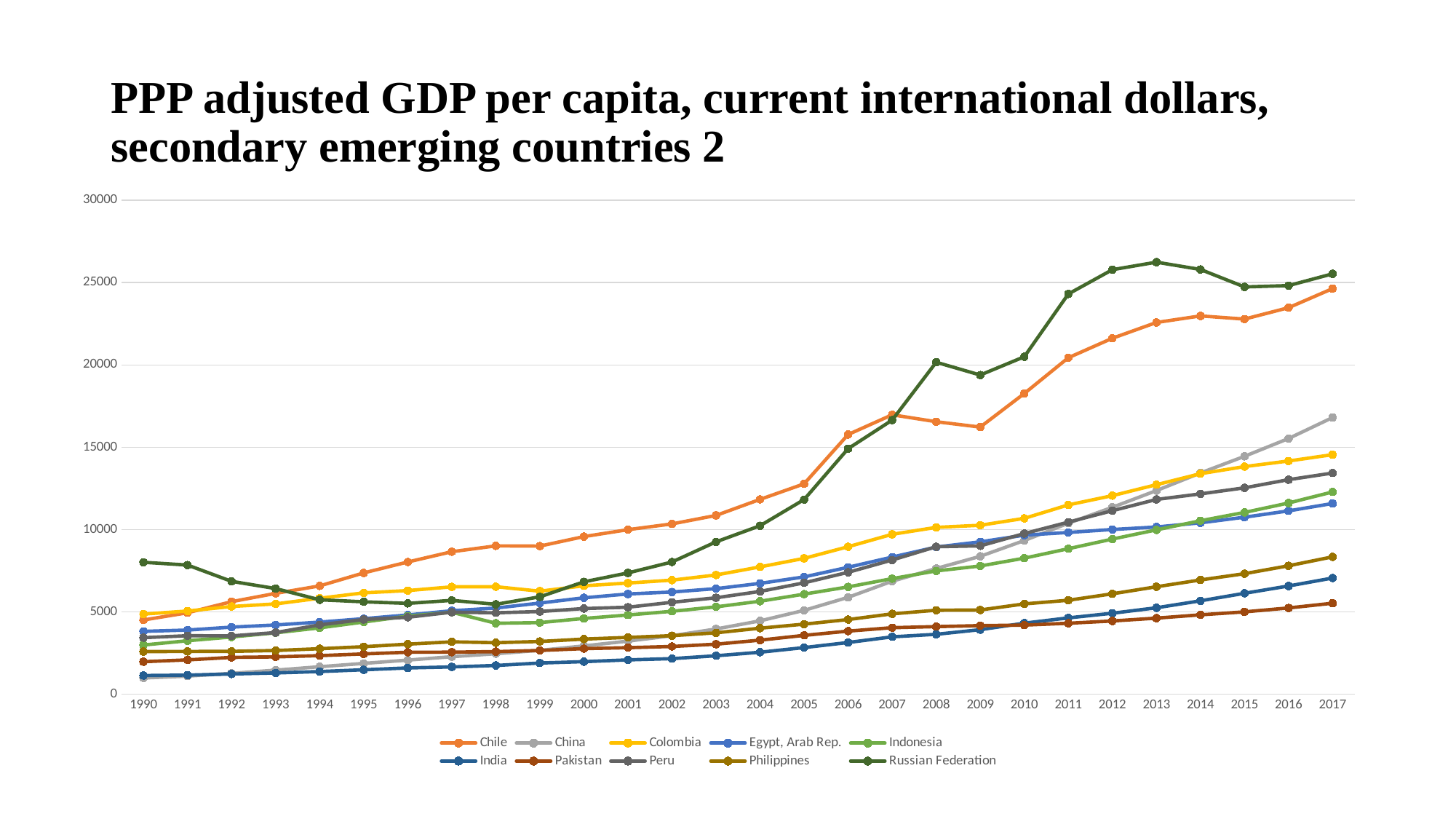
What is the title of the chart? PPP adjusted GDP per capita, current international dollars, secondary emerging countries 2 Which country has the highest PPP adjusted GDP per capita in 2017? Russian Federation Which country has the highest PPP adjusted GDP per capita in 1990? Russian Federation How many years are plotted along the x axis? 28 Does the value for Chile rise or fall from 1990 to 2017? rise How many series does the legend list? 10 What kind of chart is shown on the slide? line chart Which country has the lowest PPP adjusted GDP per capita in 2017? Pakistan Is the value for the Russian Federation in 2013 greater or less than 25000? greater Is the value for Chile in 2017 greater or less than 20000? greater In 2017, which is larger, the value for China or the value for Colombia? China Is the value for India in 2017 greater or less than 10000? less